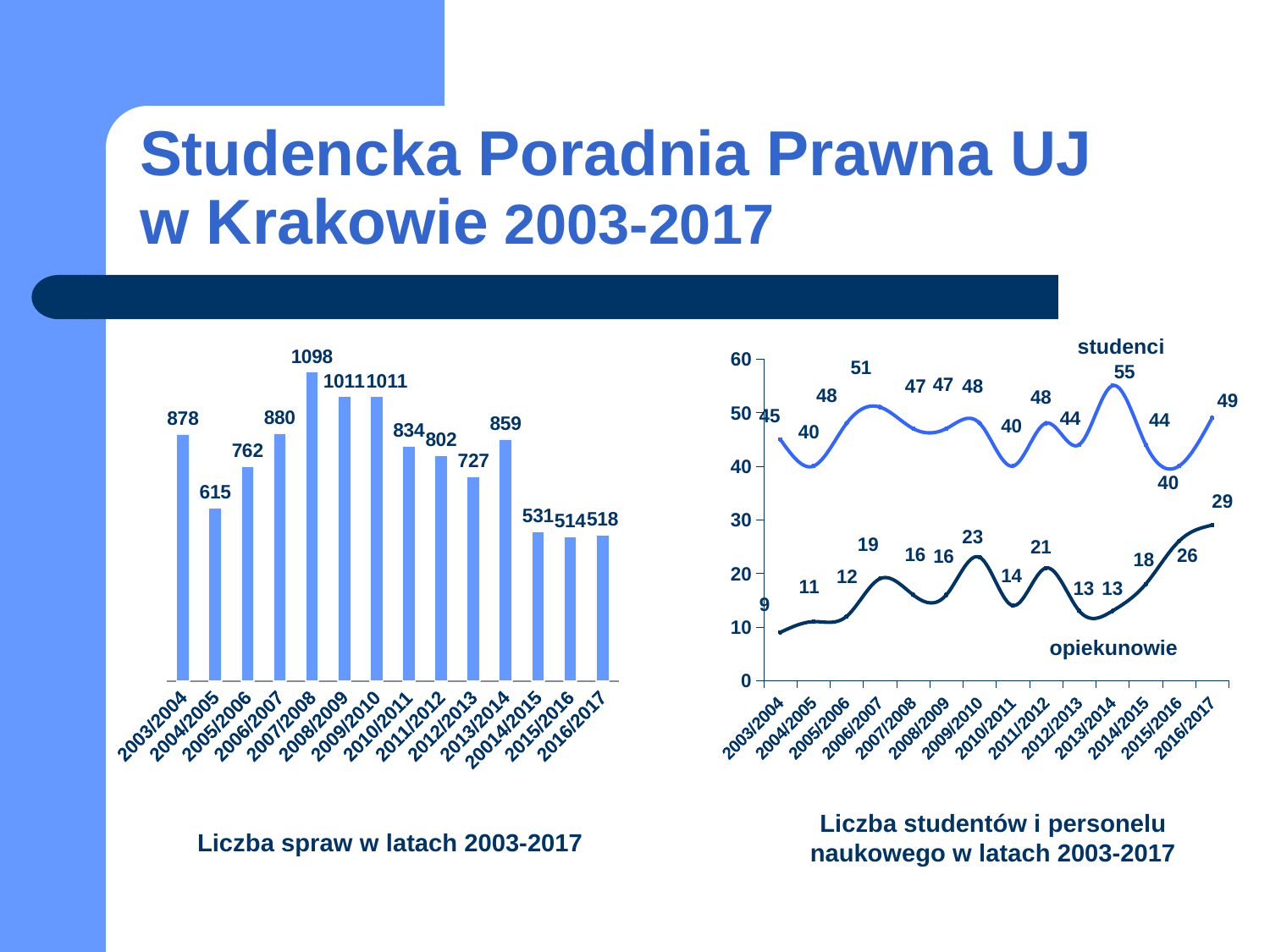
In the chart 'Liczba studentów i personelu naukowego w latach 2003-2017', what is the value for studenci in 2013/2014? 55 In the chart 'Liczba spraw w latach 2003-2017', which year has the lowest value? 2015/2016 In the chart 'Liczba studentów i personelu naukowego w latach 2003-2017', what is the difference between studenci and opiekunowie in 2009/2010? 25 In the chart 'Liczba studentów i personelu naukowego w latach 2003-2017', what is the value for opiekunowie in 2016/2017? 29 In the chart 'Liczba spraw w latach 2003-2017', which is larger, the value for 2010/2011 or 2013/2014? 2013/2014 What kind of chart is 'Liczba studentów i personelu naukowego w latach 2003-2017'? line chart In the chart 'Liczba spraw w latach 2003-2017', which year has the highest value? 2007/2008 In the chart 'Liczba spraw w latach 2003-2017', how many years are shown on the x axis? 14 In the chart 'Liczba spraw w latach 2003-2017', what is the value for 2007/2008? 1098 In the chart 'Liczba studentów i personelu naukowego w latach 2003-2017', in which year is the opiekunowie value lowest? 2003/2004 In the chart 'Liczba spraw w latach 2003-2017', what is the difference between the values for 2003/2004 and 2004/2005? 263 What kind of chart is 'Liczba spraw w latach 2003-2017'? bar chart